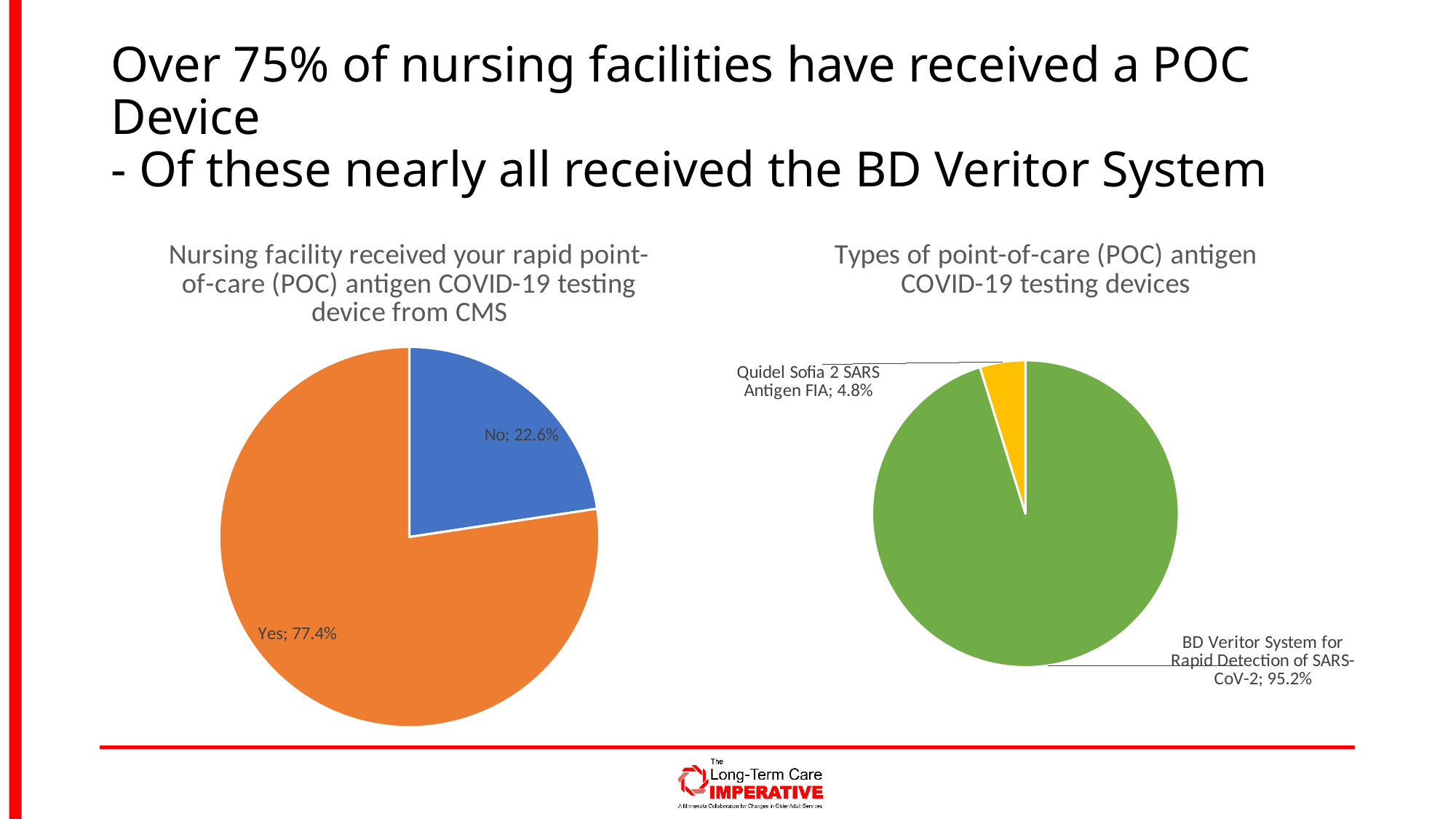
In the left chart (Nursing facility received your rapid POC device from CMS), which category is the largest? Yes In the right chart (Types of point-of-care (POC) antigen COVID-19 testing devices), which device has the smallest share? Quidel Sofia 2 SARS Antigen FIA In the right chart (Types of point-of-care (POC) antigen COVID-19 testing devices), which is larger: the BD Veritor System share or the Quidel Sofia 2 share? BD Veritor System for Rapid Detection of SARS-CoV-2 In the left chart (Nursing facility received your rapid POC device from CMS), what is the value for 'No'? 22.6% In the left chart (Nursing facility received your rapid POC device from CMS), what is the difference between the 'Yes' and 'No' shares? 54.8% In the right chart (Types of point-of-care (POC) antigen COVID-19 testing devices), what is the difference between the BD Veritor System share and the Quidel Sofia 2 share? 90.4% In the right chart (Types of point-of-care (POC) antigen COVID-19 testing devices), what share is the BD Veritor System for Rapid Detection of SARS-CoV-2? 95.2% In the left chart (Nursing facility received your rapid POC device from CMS), how many slices does the pie have? 2 What kind of chart is the left chart (Nursing facility received your rapid POC device from CMS)? Pie chart In the right chart (Types of point-of-care (POC) antigen COVID-19 testing devices), what is the value for Quidel Sofia 2 SARS Antigen FIA? 4.8% In the left chart (Nursing facility received your rapid POC device from CMS), what share of the pie is 'Yes'? 77.4% In the right chart (Types of point-of-care (POC) antigen COVID-19 testing devices), what colour is the BD Veritor System slice? Green